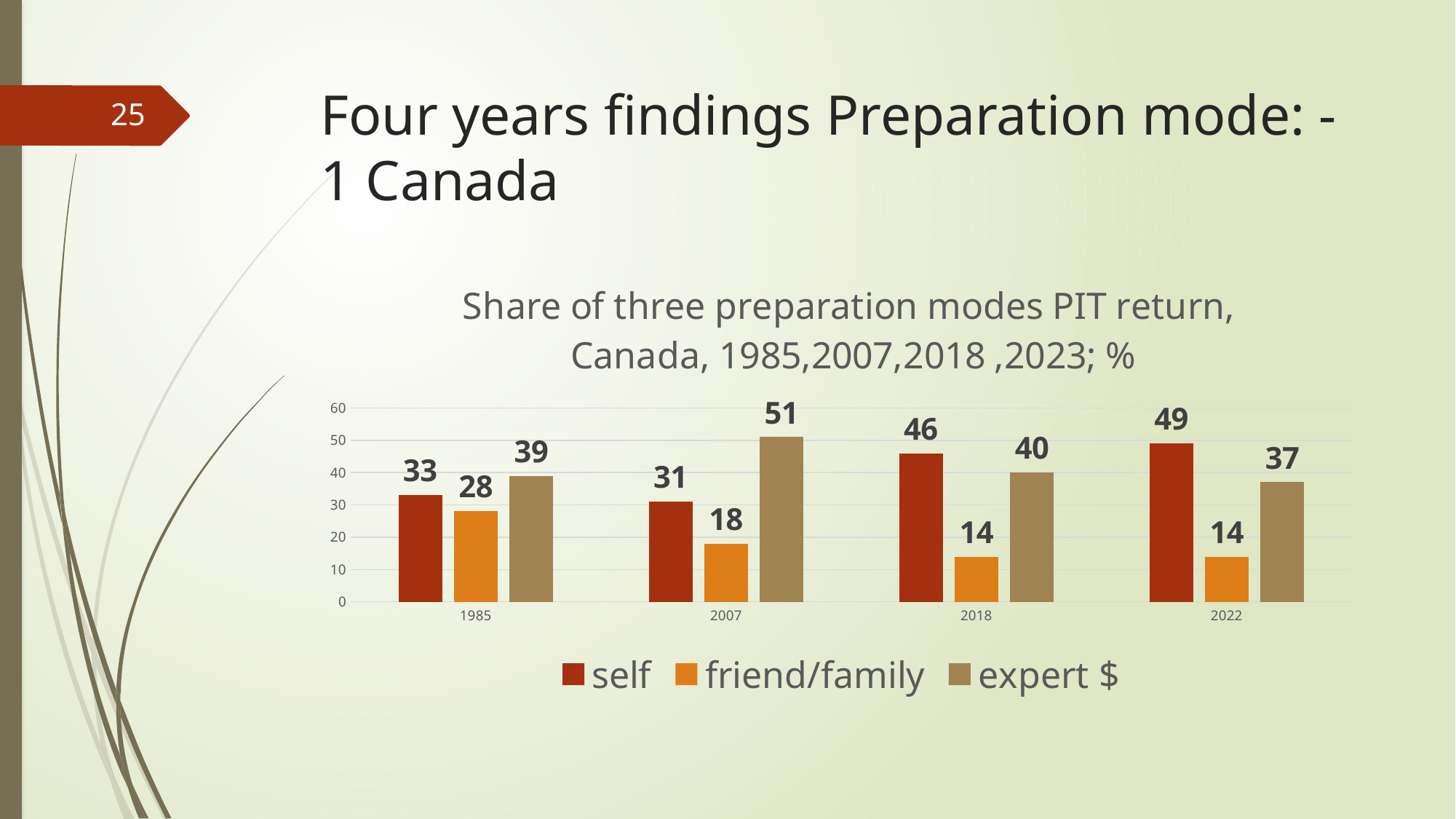
Which is larger in 2018, self or expert $? self Does the friend/family series rise or fall from 1985 to 2018? fall What is the value for expert $ in 2007? 51 In which year is the self series highest? 2022 What is the value for self in 2022? 49 In which year is the expert $ series lowest? 2022 What is the difference between expert $ and self in 2007? 20 How many series does the legend list? 3 How many years are shown on the x axis? 4 What is the value for friend/family in 2018? 14 What is the value for self in 1985? 33 What kind of chart is shown? bar chart